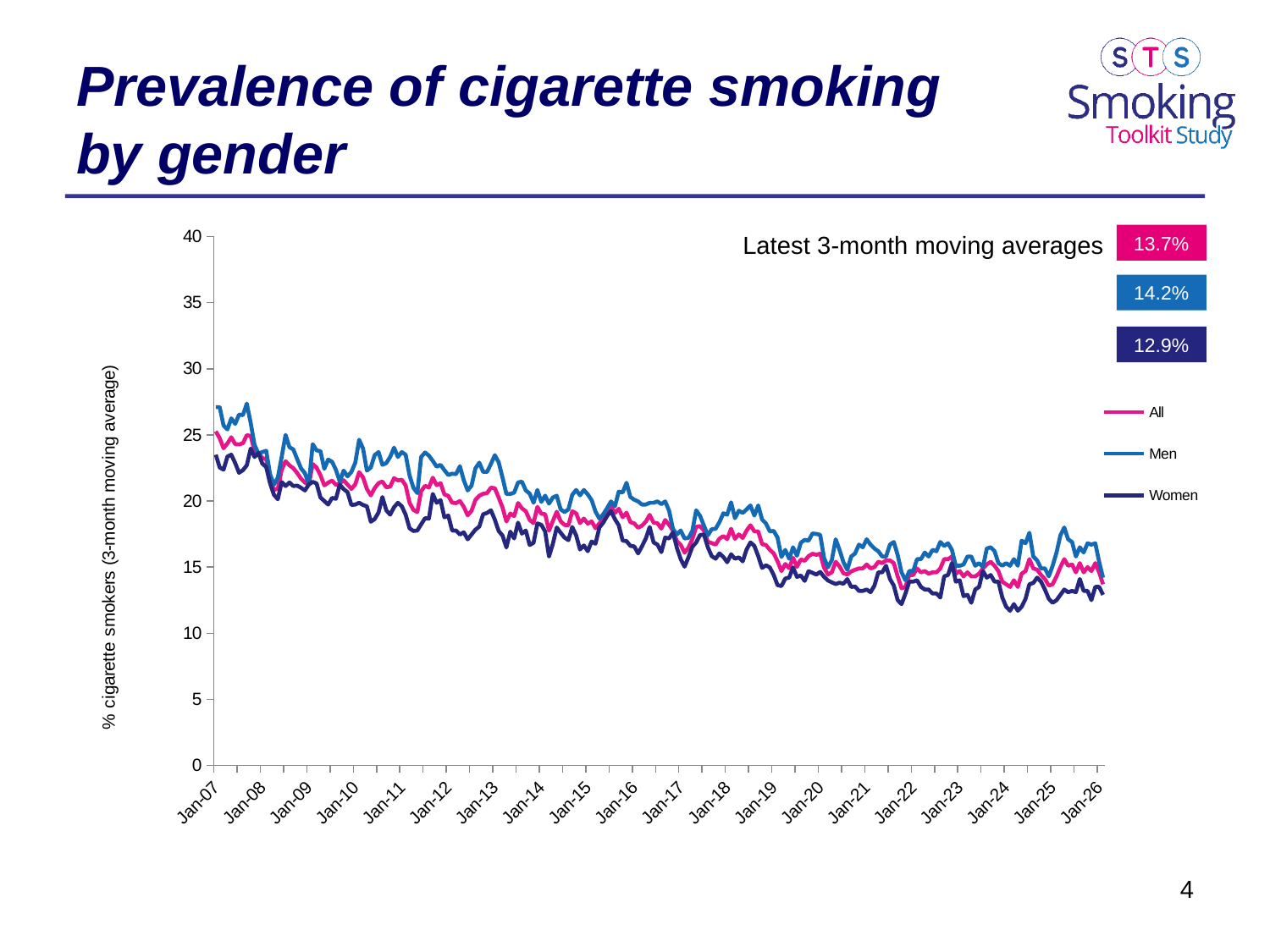
Do the smoking prevalence lines rise or fall from Jan-07 to Jan-26? fall Which group has the lowest latest 3-month moving average? Women What kind of chart is shown on the slide? line chart How many series does the legend list? 3 Is the value for Men at Jan-07 greater or less than 25? greater What is the latest 3-month moving average for Women? 12.9% Which group has the highest latest 3-month moving average? Men Is the latest 3-month moving average larger for Men or for All? Men What is the label on the y axis of the chart? % cigarette smokers (3-month moving average) What is the latest 3-month moving average for All? 13.7% What is the difference between the latest 3-month moving averages for Men and Women? 1.3 percentage points What is the latest 3-month moving average for Men? 14.2%